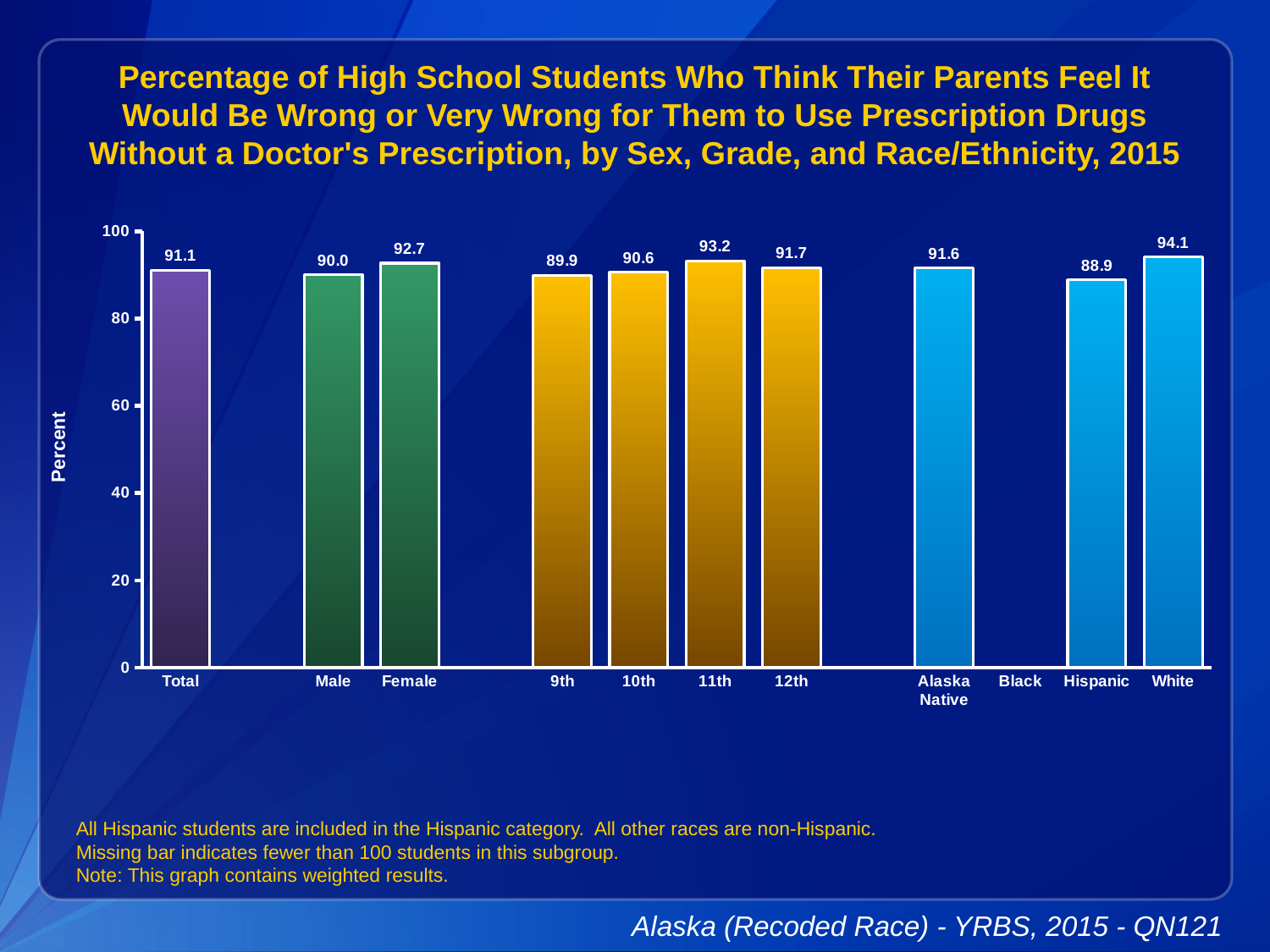
Which category with a bar has the lowest value? Hispanic What is the value for Hispanic? 88.9 What is the value for 11th grade? 93.2 How many categories are labeled on the x axis? 11 What is the difference between the Female and Male values? 2.7 Which category has the highest value? White Which category on the x axis has no bar? Black What is the value for Female? 92.7 What kind of chart is shown? bar chart Is the value for Alaska Native greater or less than 80? greater Which is larger, the value for 9th grade or 12th grade? 12th What is the value for Total? 91.1